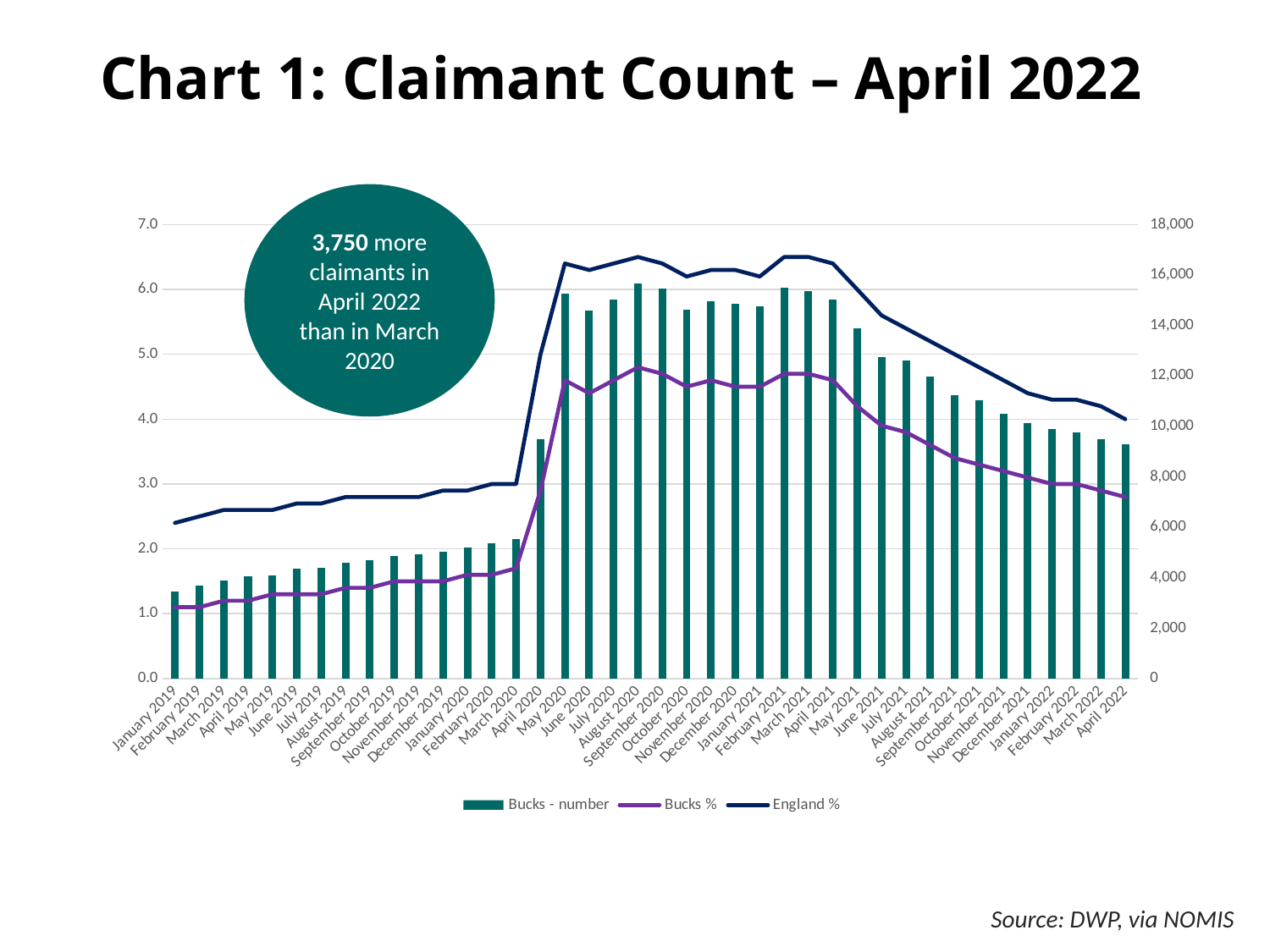
How many series does the legend list? 3 Which is larger in April 2022, the England % value or the Bucks % value? England % Is the Bucks - number value for April 2022 greater or less than 10,000? less Is the Bucks - number value for May 2020 greater or less than 14,000? greater In which month is the Bucks - number bar lowest? January 2019 Is the Bucks % value for April 2022 greater or less than 3.0? less According to the callout on the chart, how many more claimants were there in April 2022 than in March 2020? 3,750 How many months are plotted along the x axis? 40 What kind of chart is shown on the slide? A combined bar and line chart Do the Bucks - number bars rise or fall from August 2020 to April 2022? fall In which month is the England % line at its lowest? January 2019 Which series are listed in the legend? Bucks - number, Bucks %, England %